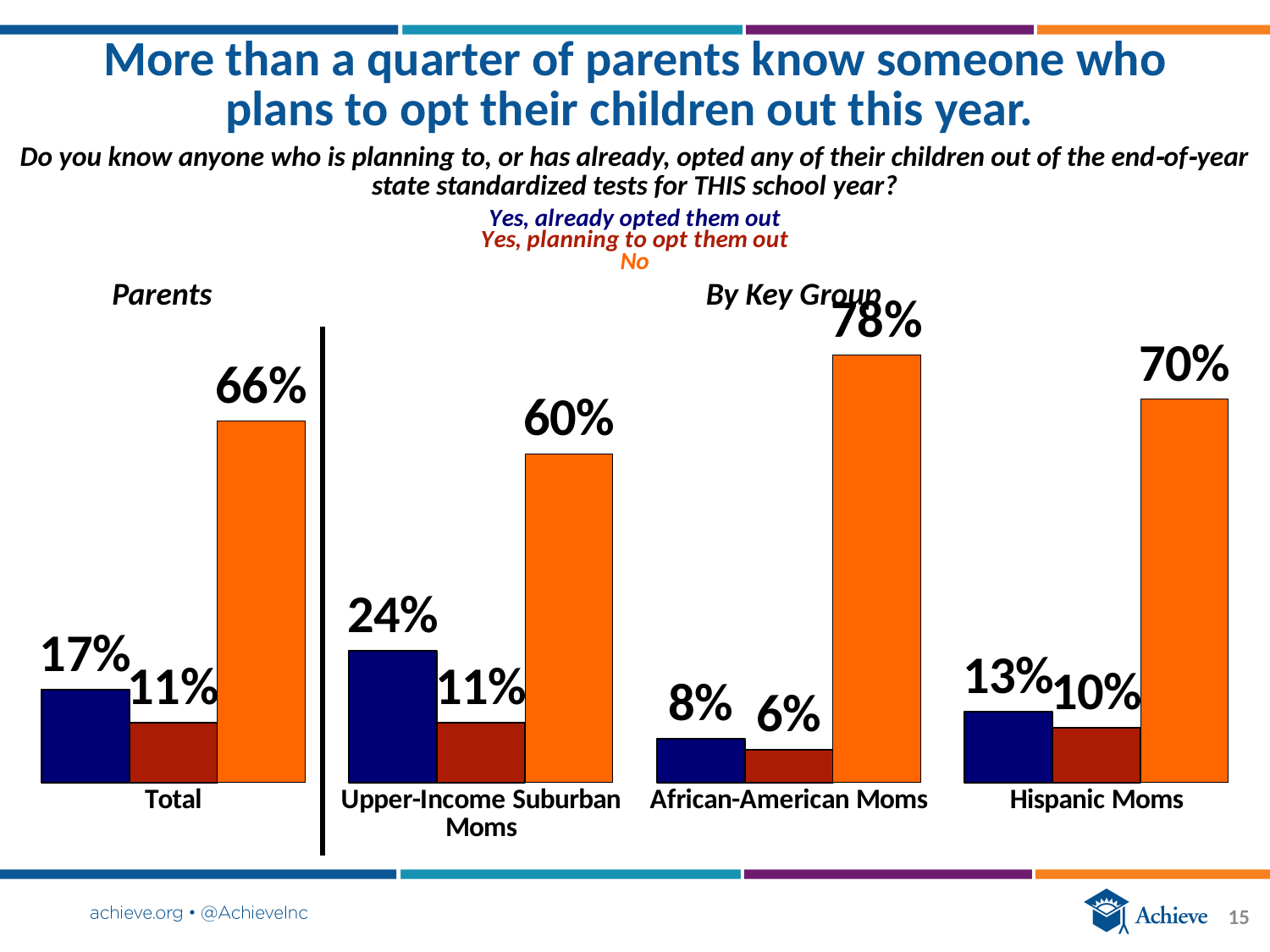
Which group has the highest "No" percentage? African-American Moms Which is larger: the "Yes, already opted them out" value for Upper-Income Suburban Moms or for Total? Upper-Income Suburban Moms What is the difference between the "No" percentage for African-American Moms and for Upper-Income Suburban Moms? 18% How many response series does the legend list? 3 How many groups are shown along the x axis of the chart? 4 What percentage of Upper-Income Suburban Moms said "Yes, already opted them out"? 24% What percentage of African-American Moms said "Yes, planning to opt them out"? 6% What kind of chart is shown on the slide? Bar chart Which colour represents the "No" response in the chart? Orange Which group has the lowest "Yes, already opted them out" percentage? African-American Moms What percentage of Hispanic Moms said "Yes, already opted them out"? 13% What percentage of Total parents answered "No"? 66%